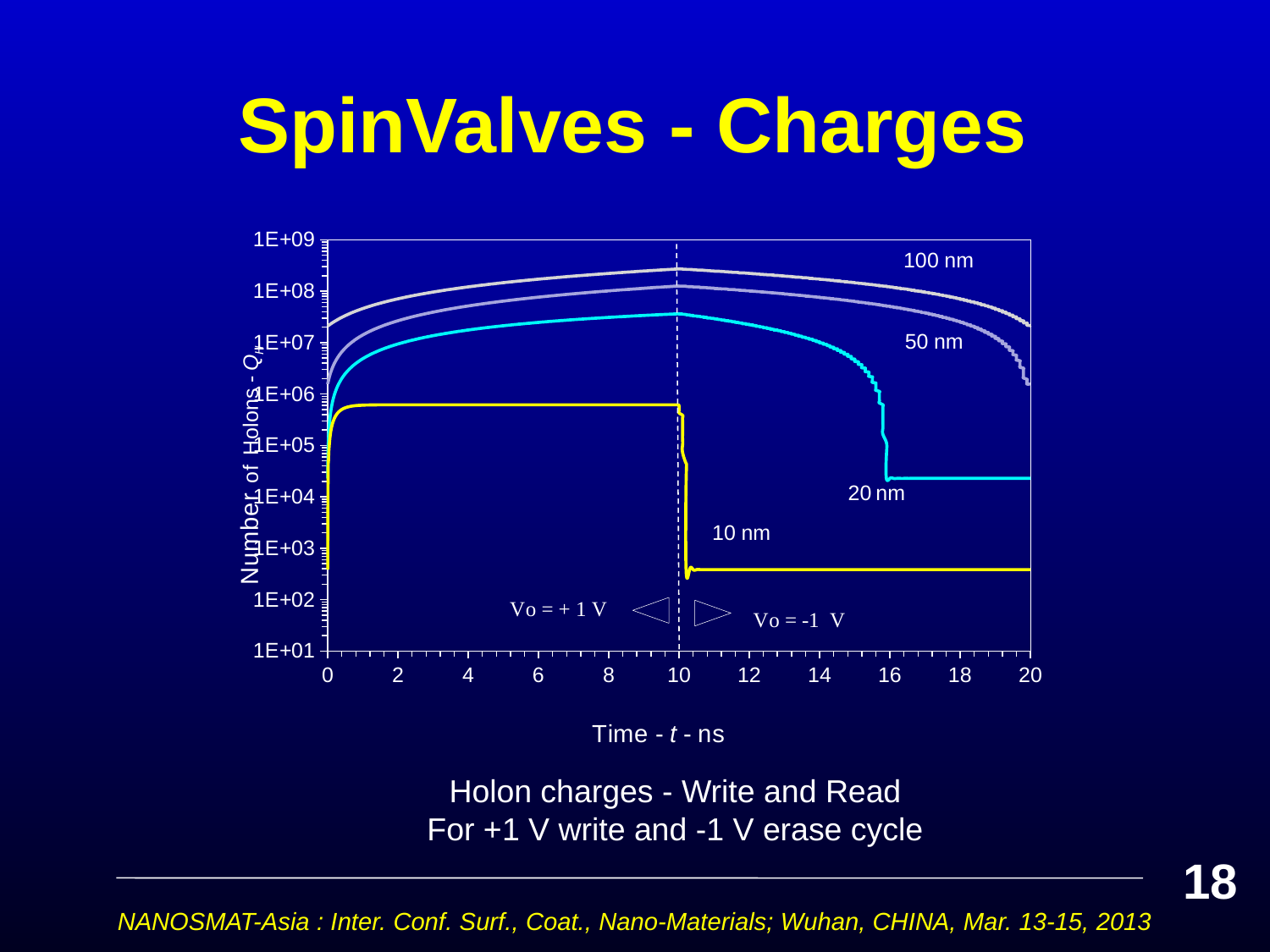
What kind of chart is shown on the slide? line chart What is the title of the slide? SpinValves - Charges At t = 18 ns, which curve has the larger value, 50 nm or 20 nm? 50 nm At t = 18 ns, is the value for the 20 nm curve greater or less than 1E+05? less Which curve has the lowest number of holons at t = 15 ns? 10 nm Which curve has the highest number of holons at t = 10 ns? 100 nm How many thickness curves are labelled on the chart? 4 Does the 10 nm curve rise or fall immediately after t = 10 ns? fall At t = 15 ns, is the value for the 10 nm curve greater or less than 1E+03? less At t = 10 ns, is the value for the 100 nm curve greater or less than 1E+08? greater What is the label of the x axis? Time - t - ns